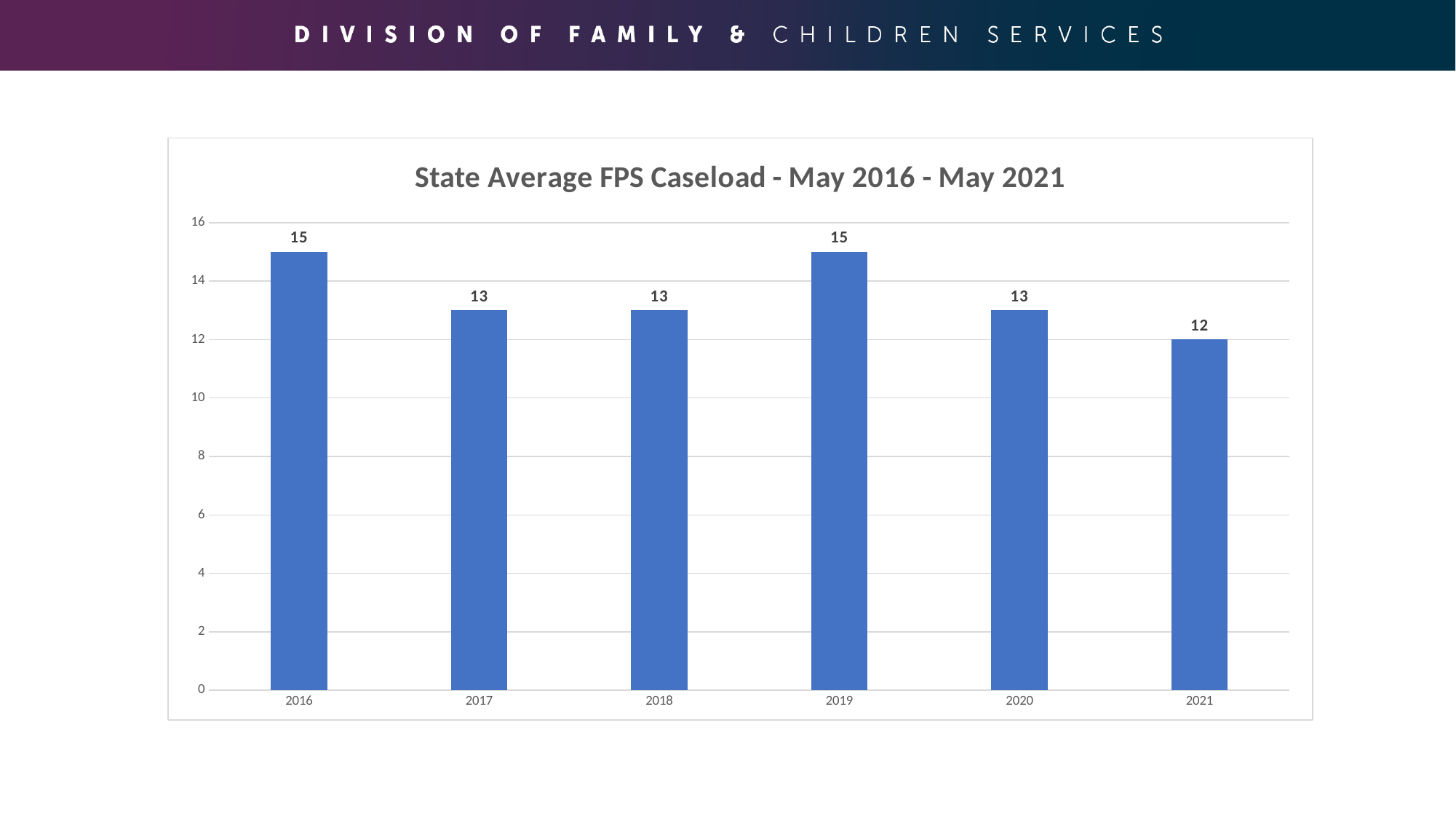
Which year has the lowest state average FPS caseload? 2021 What kind of chart is shown on the slide? bar chart What is the state average FPS caseload for 2021? 12 What is the value shown for 2020? 13 Is the value for 2017 greater or less than 14? less Which is larger, the value for 2018 or the value for 2021? 2018 What is the difference between the values for 2019 and 2020? 2 What is the title of the chart? State Average FPS Caseload - May 2016 - May 2021 What is the state average FPS caseload for 2016? 15 What is the value shown for 2019? 15 What is the difference between the caseload in 2016 and the caseload in 2021? 3 How many years are shown on the x axis? 6